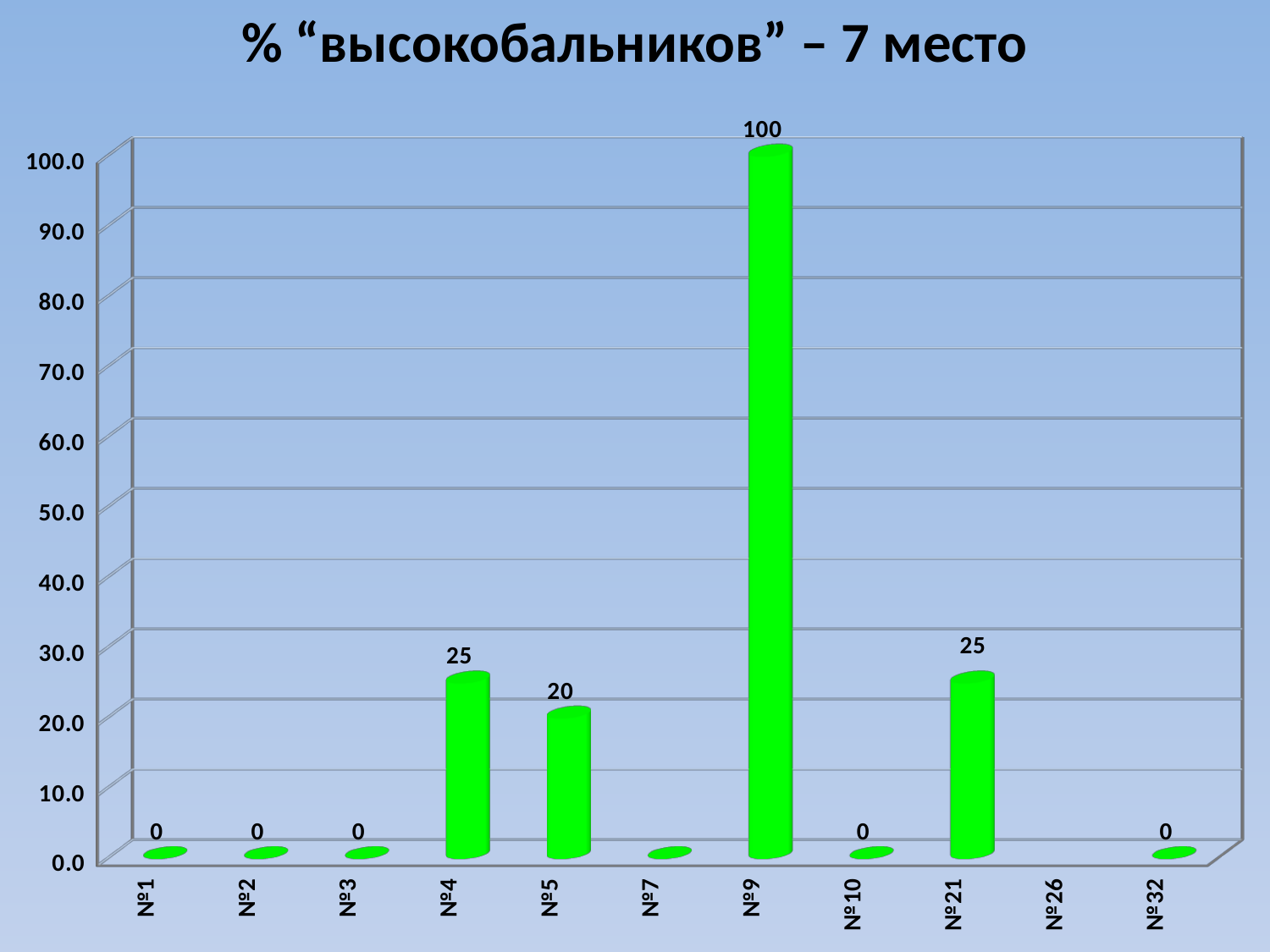
Which category has the highest value? №9 Is the value for №9 greater or less than 50? greater What is the difference between the values for №9 and №4? 75 Which is larger, the value for №5 or the value for №21? №21 What is the value for №4? 25 How many categories are shown on the x axis? 11 What kind of chart is shown on the slide? bar chart What is the value for №9? 100 What is the value for №21? 25 What is the difference between the values for №4 and №5? 5 What is the value for №10? 0 What is the value for №5? 20